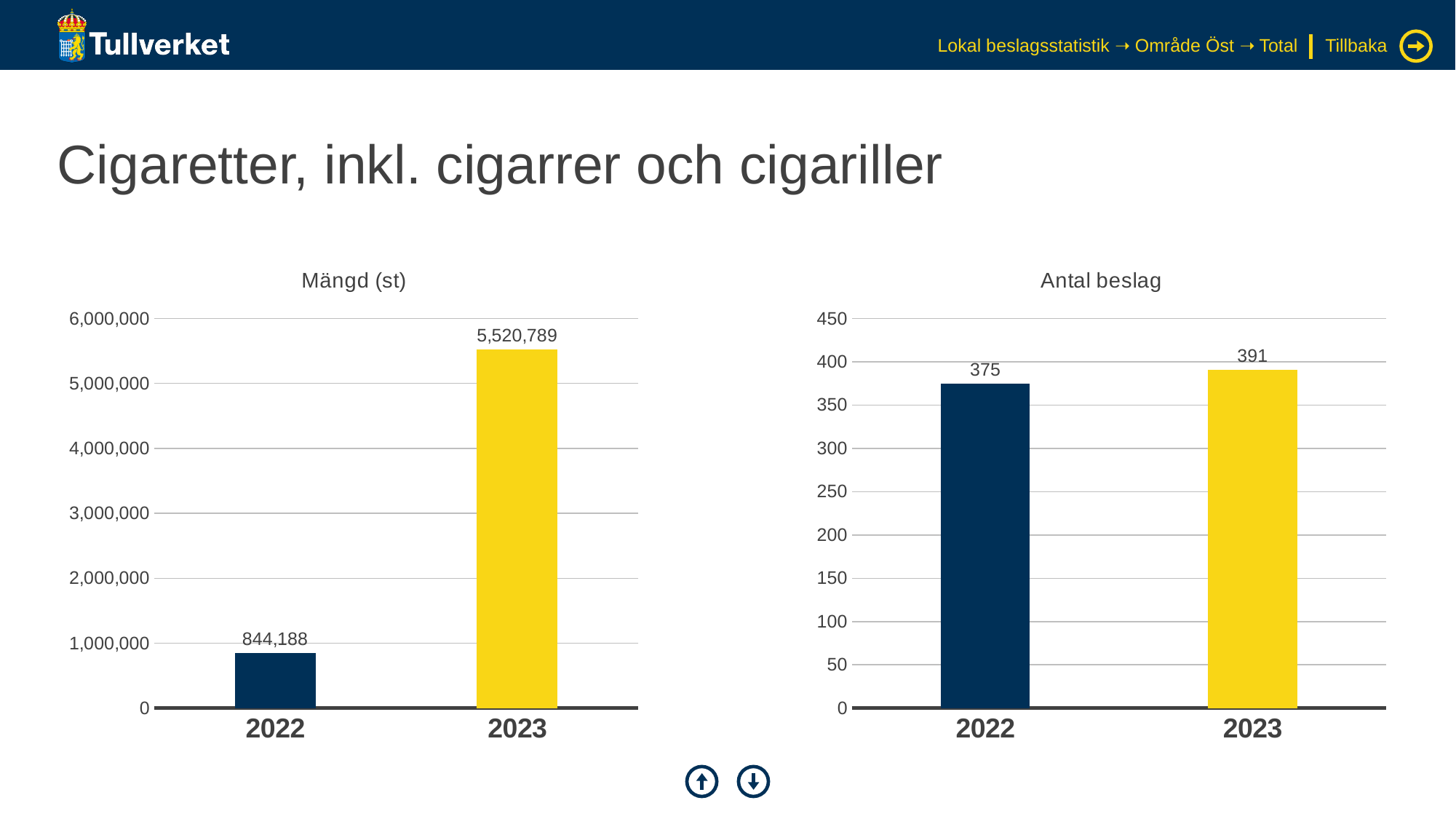
In the 'Antal beslag' chart, do the values rise or fall from 2022 to 2023? rise How many categories are shown on the x axis of the 'Antal beslag' chart? 2 In the 'Mängd (st)' chart, what is the difference between the 2023 and 2022 values? 4,676,601 In the 'Antal beslag' chart, what is the value for 2023? 391 In the 'Mängd (st)' chart, which year has the highest value? 2023 In the 'Antal beslag' chart, what is the difference between the 2023 and 2022 values? 16 In the 'Mängd (st)' chart, is the value for 2022 greater or less than 1,000,000? less In the 'Antal beslag' chart, which year has the lowest value? 2022 In the 'Mängd (st)' chart, what is the value for 2023? 5,520,789 In the 'Antal beslag' chart, what is the value for 2022? 375 In the 'Mängd (st)' chart, what is the value for 2022? 844,188 What kind of chart is the 'Mängd (st)' chart? bar chart